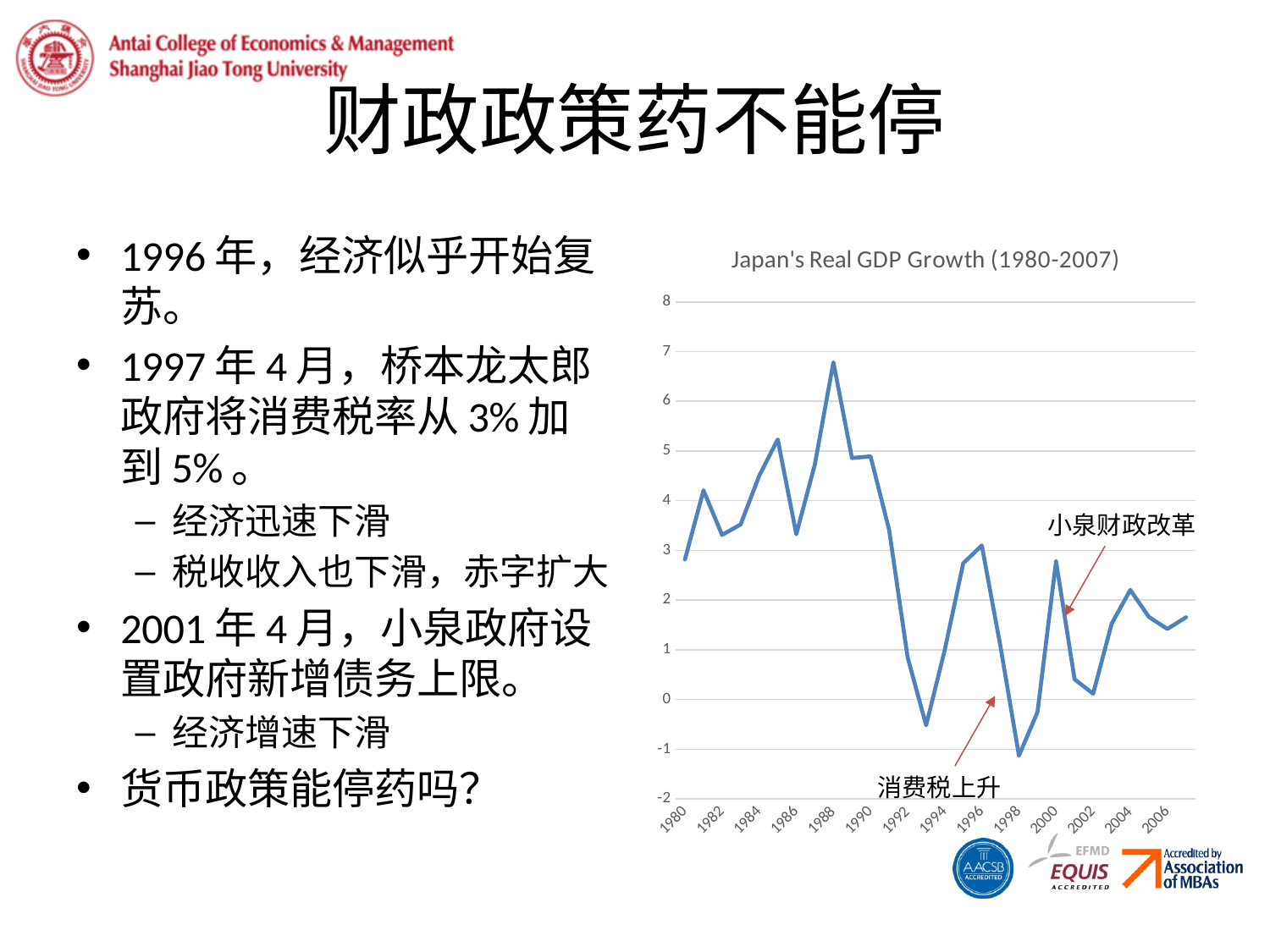
Does Japan's real GDP growth rise or fall between 1988 and 1993? fall What kind of chart is shown on the slide? line chart Is the value for 2002 greater or less than 1? less Is the value for 1998 greater or less than 0? less What is the title of the chart? Japan's Real GDP Growth (1980-2007) Which year has the higher real GDP growth, 1988 or 1996? 1988 In which year does Japan's real GDP growth reach its highest point on the chart? 1988 Is the value for 1990 greater or less than 4? greater Which annotation on the chart points to the drop around 1997? 消费税上升 In which year does Japan's real GDP growth reach its lowest point on the chart? 1998